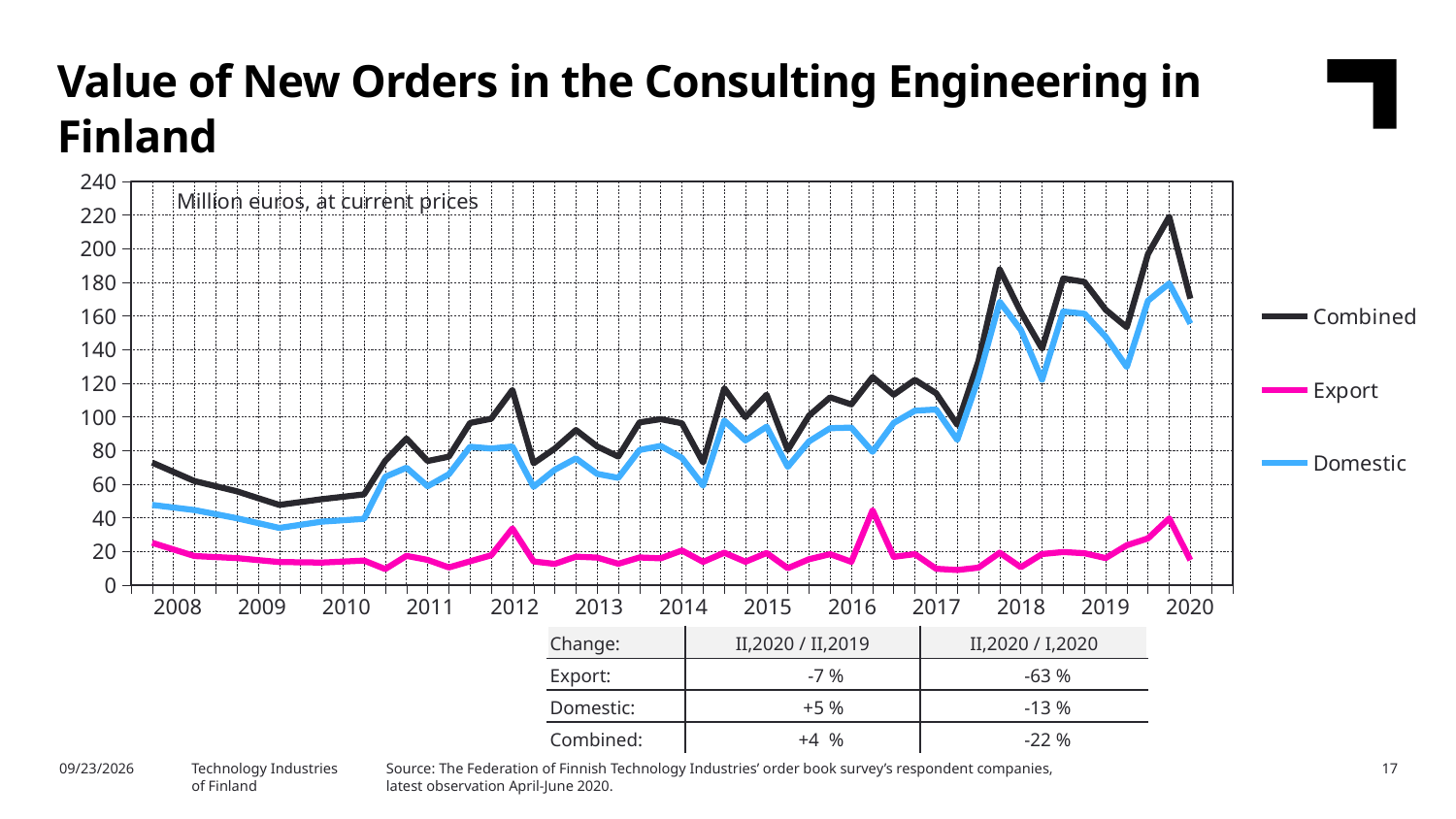
Is the value of the Combined series at the start of 2008 greater or less than 60? greater How many series does the legend list? 3 What unit is stated inside the chart area? Million euros, at current prices How many years are labelled on the x axis? 13 In 2018, which series has the larger values, Domestic or Export? Domestic Does the Combined series overall rise or fall from 2008 to 2020? rise Which series has the highest values across the whole period? Combined Which series is plotted with the lowest values across the whole period? Export Is the value of the Domestic series at the start of 2008 greater or less than 60? less Is the peak value of the Combined series, reached just before 2020, greater or less than 200? greater What kind of chart is shown on the slide? line chart